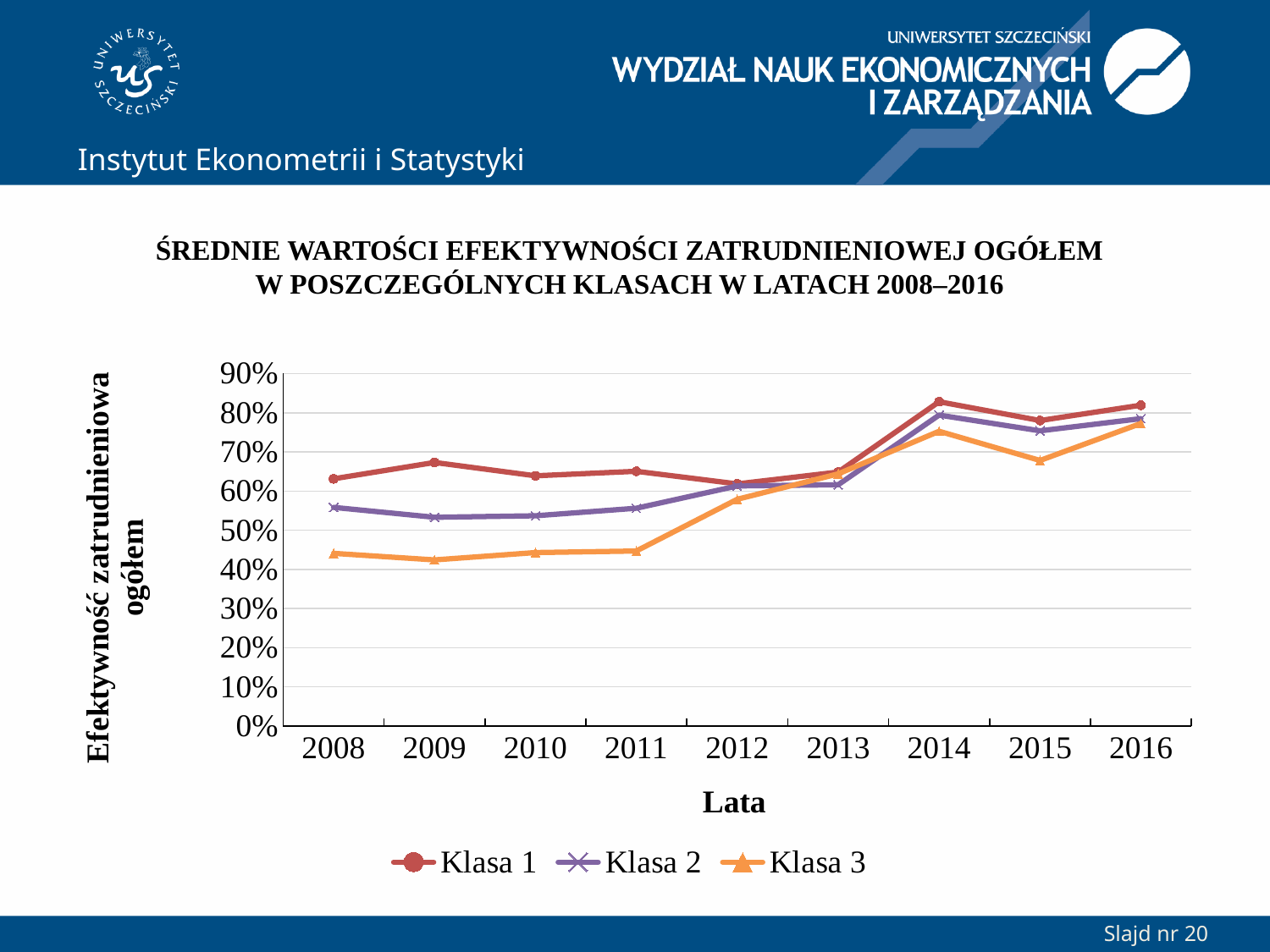
What kind of chart is shown on the slide? line chart Which series has the highest value in 2015? Klasa 1 Is the value for Klasa 3 in 2008 greater or less than 50%? less What is the title of the x axis? Lata How many years are shown on the x axis? 9 Does the value for Klasa 3 rise or fall from 2011 to 2014? rise Which series has the lowest value in 2008? Klasa 3 In 2011, which is larger: the value for Klasa 2 or Klasa 3? Klasa 2 Is the value for Klasa 2 in 2015 greater or less than 70%? greater Is the value for Klasa 1 in 2014 greater or less than 80%? greater In 2009, which is larger: the value for Klasa 1 or Klasa 3? Klasa 1 How many series does the legend list? 3